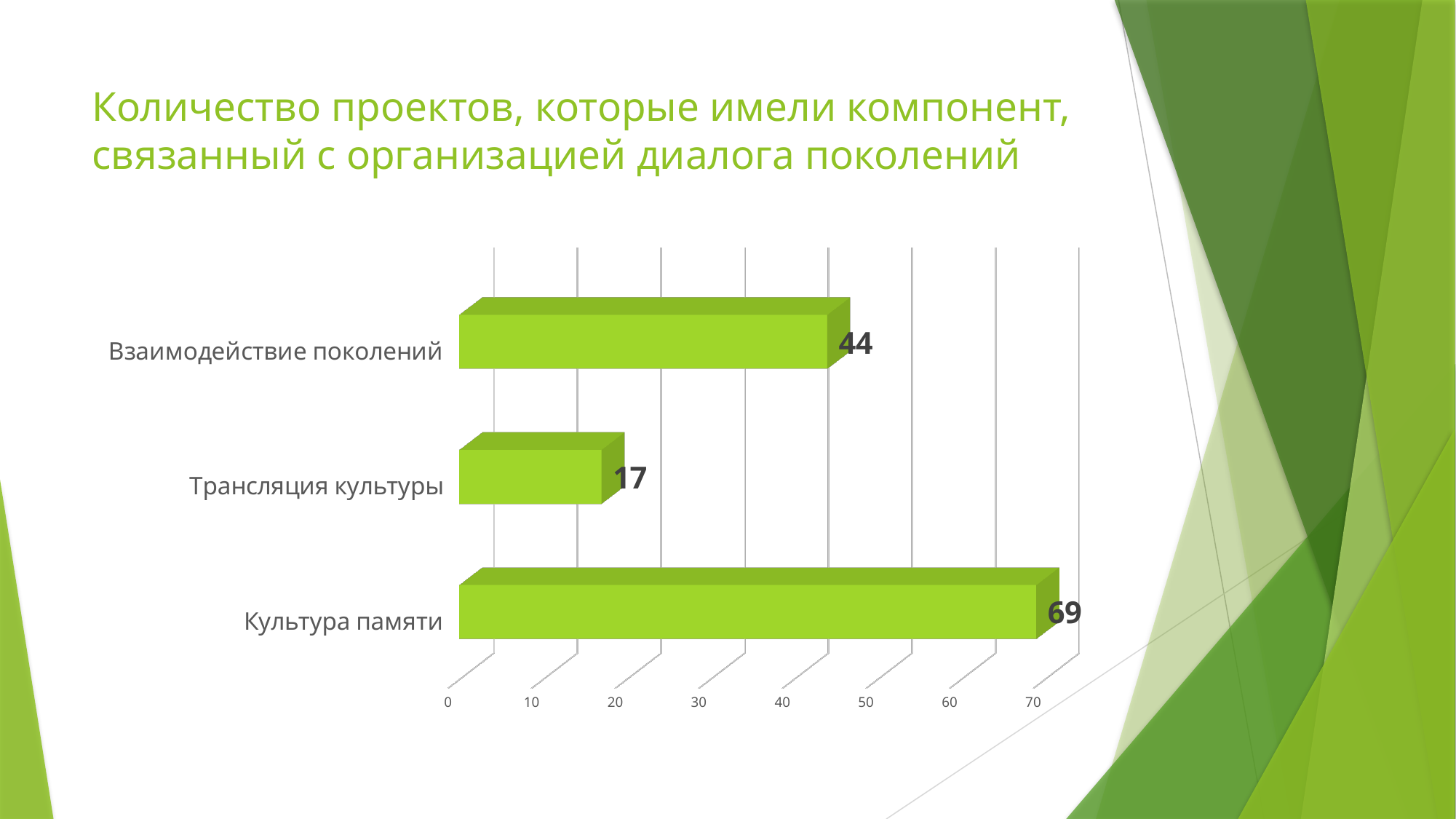
What is the difference between the values for Культура памяти and Взаимодействие поколений? 25 What is the difference between the values for Взаимодействие поколений and Трансляция культуры? 27 What is the title of the slide? Количество проектов, которые имели компонент, связанный с организацией диалога поколений How many categories are shown in the chart? 3 Which category has the highest value? Культура памяти What is the value for Трансляция культуры? 17 What is the value for Культура памяти? 69 Is the value for Культура памяти greater or less than 60? greater What kind of chart is shown on the slide? bar chart Which category has the lowest value? Трансляция культуры Which is larger, the value for Взаимодействие поколений or the value for Трансляция культуры? Взаимодействие поколений What is the value for Взаимодействие поколений? 44